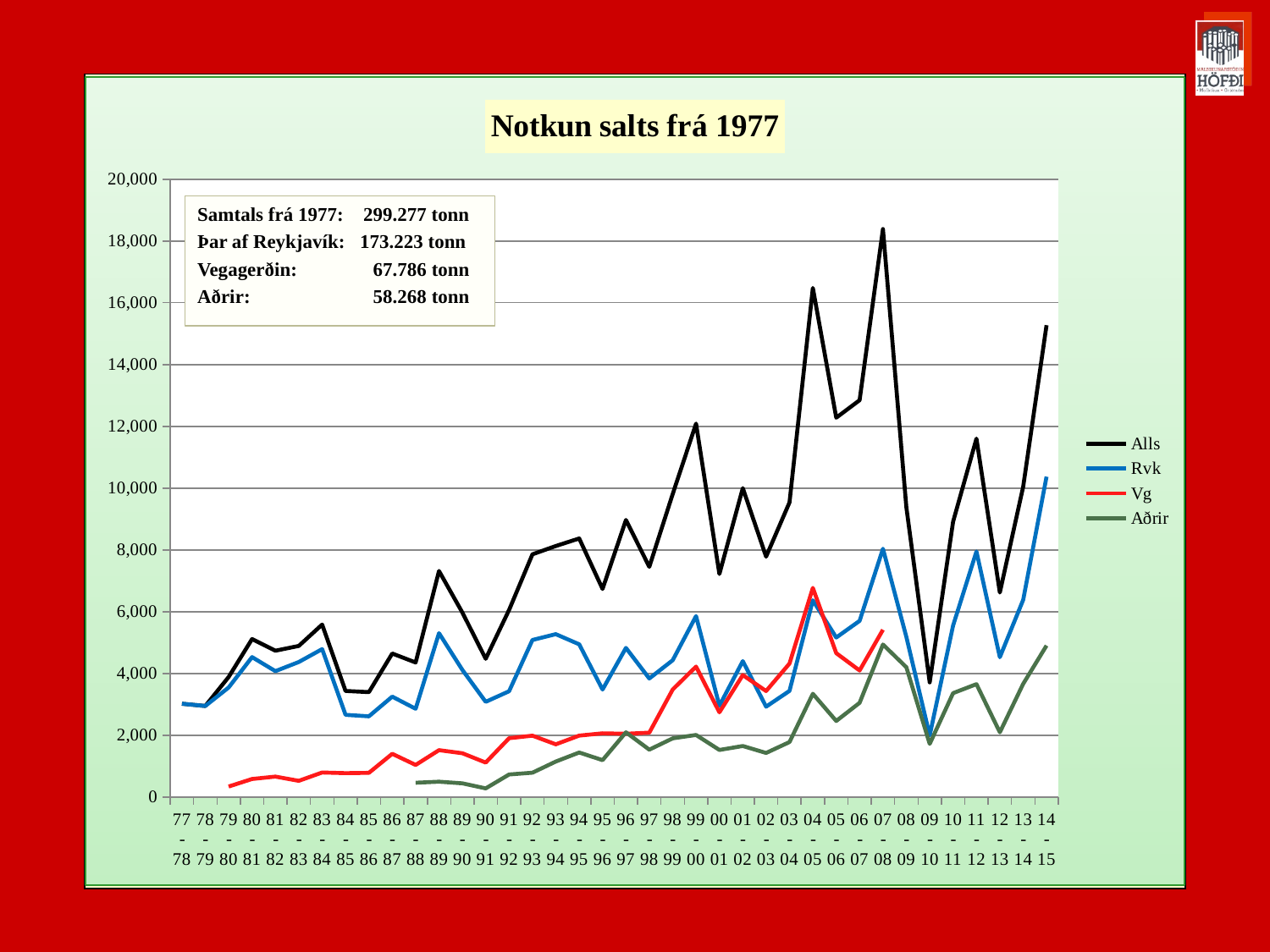
Is the value of Rvk in 14-15 greater or less than 8,000? greater In 14-15, which is larger, Rvk or Aðrir? Rvk Which series is drawn in black? Alls Is the value of Alls in 09-10 greater or less than 6,000? less How many series does the legend list? 4 Is the value of Vg in 79-80 greater or less than 2,000? less Does the Alls series generally rise or fall from 77-78 to 14-15? rise What is the title of the chart? Notkun salts frá 1977 In which season does the Alls series reach its highest value? 07-08 What kind of chart is shown on the slide? line chart How many seasons are plotted along the x axis? 38